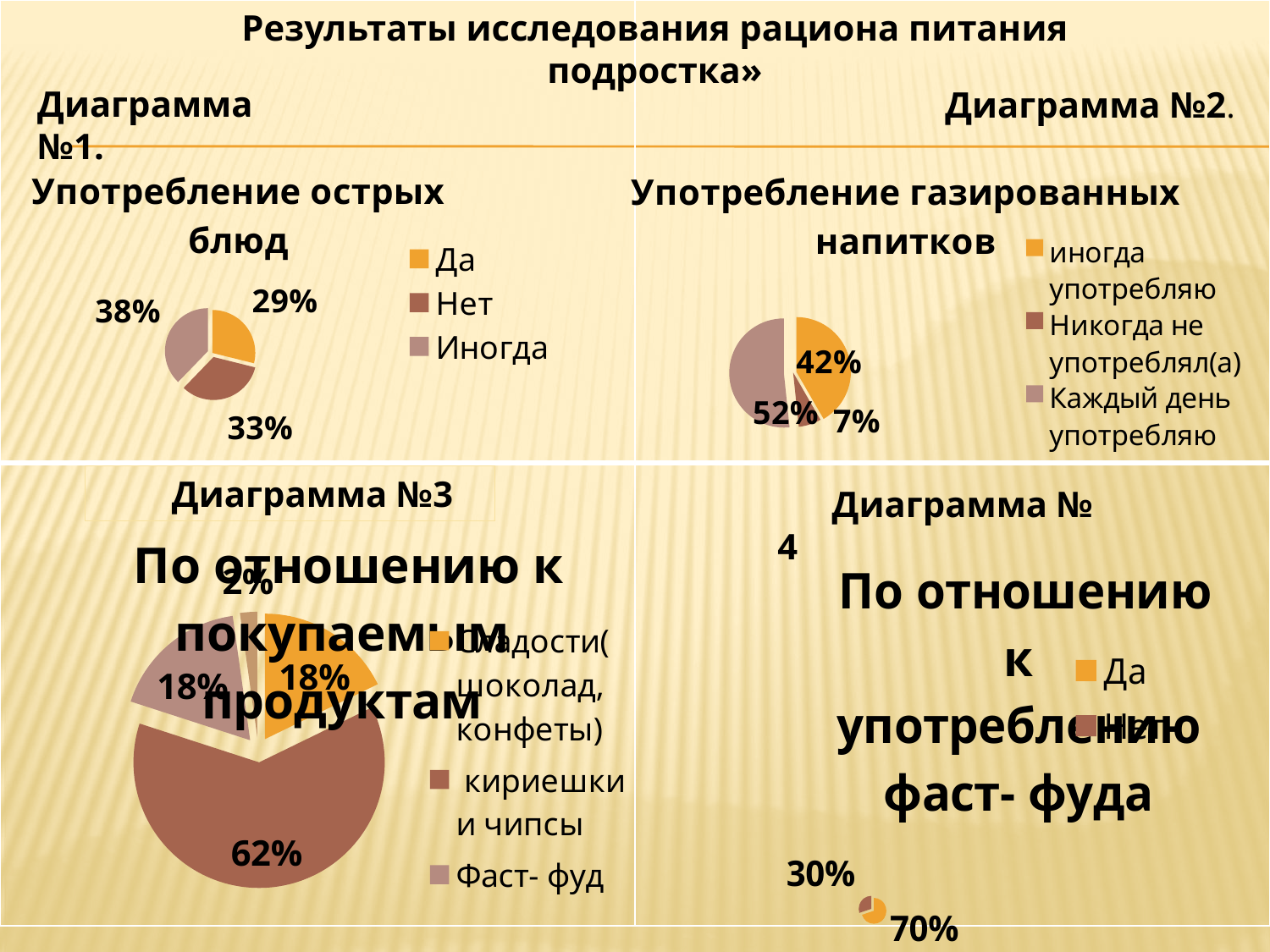
In the chart 'Употребление острых блюд' (Диаграмма №1), what is the difference between the 'Иногда' and 'Да' shares? 9% In the chart 'Употребление газированных напитков' (Диаграмма №2), which category has the largest share? Каждый день употребляю In the chart 'Употребление острых блюд' (Диаграмма №1), what percentage is shown for 'Нет'? 33% In the chart 'Употребление газированных напитков' (Диаграмма №2), what percentage is shown for 'Никогда не употреблял(а)'? 7% How many charts are shown on the slide? 4 In the chart 'По отношению к употреблению фаст-фуда' (Диаграмма №4), what percentage is shown for 'Да'? 70% In the chart 'Употребление газированных напитков' (Диаграмма №2), how many categories does the legend list? 3 In the chart 'По отношению к употреблению фаст-фуда' (Диаграмма №4), what is the difference between the 'Да' and 'Нет' shares? 40% What type of chart is 'Употребление острых блюд' (Диаграмма №1)? Pie chart In the chart 'По отношению к покупаемым продуктам' (Диаграмма №3), what percentage is shown for 'кириешки и чипсы'? 62% In the chart 'Употребление острых блюд' (Диаграмма №1), which category has the largest share? Иногда